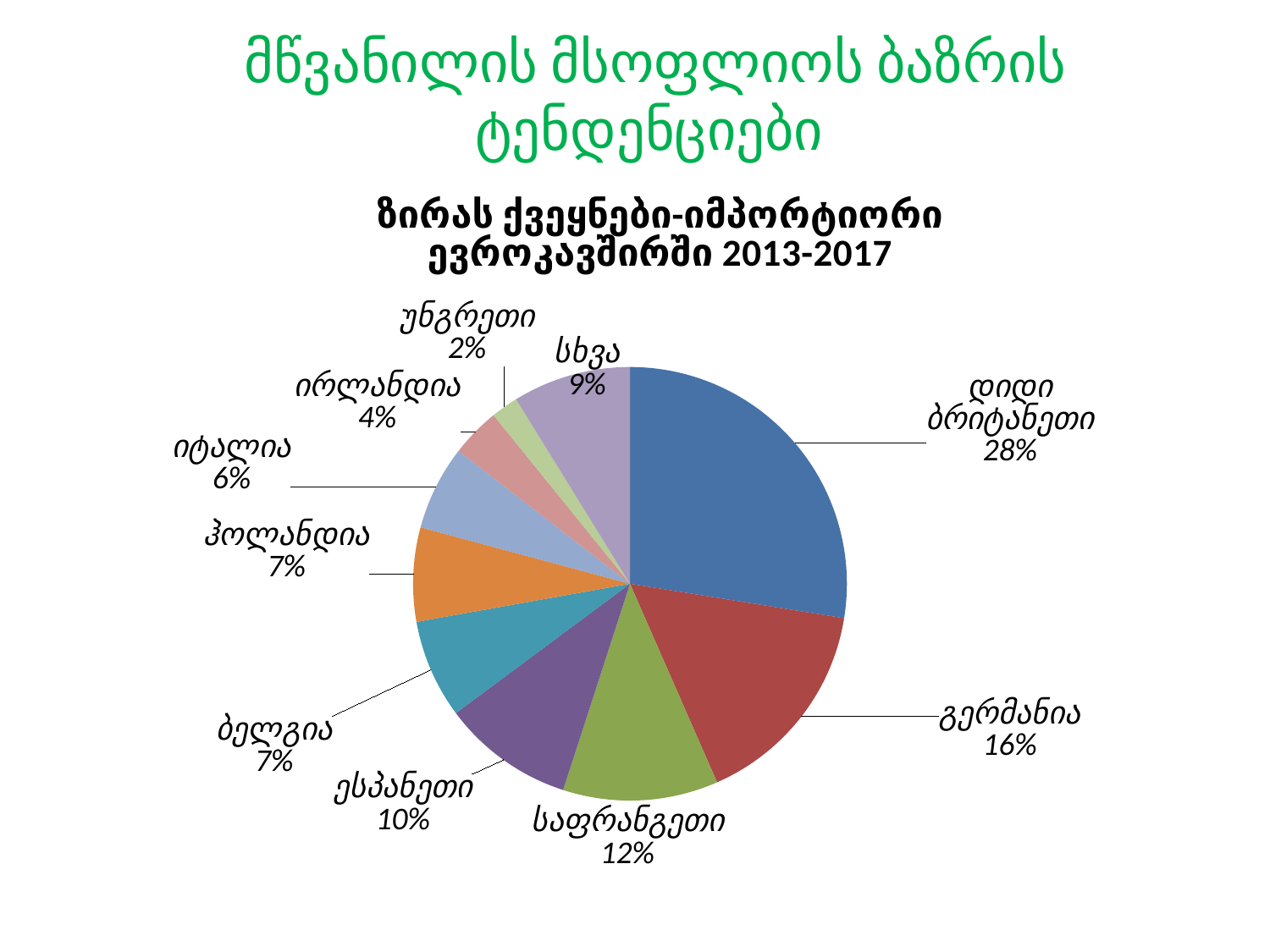
What type of chart is shown on the slide? pie chart What is the value shown for საფრანგეთი? 12% What is the value shown for ესპანეთი? 10% What is the value shown for სხვა? 9% What is the difference between the shares of დიდი ბრიტანეთი and გერმანია? 12% What is the title of the pie chart? ზირას ქვეყნები-იმპორტიორი ევროკავშირში 2013-2017 What is the value shown for გერმანია? 16% How many slices does the pie chart have? 10 What share of the pie does დიდი ბრიტანეთი hold? 28% Which category has the largest slice of the pie? დიდი ბრიტანეთი Which category has the smallest slice of the pie? უნგრეთი Which is larger, the share of იტალია or the share of ირლანდია? იტალია